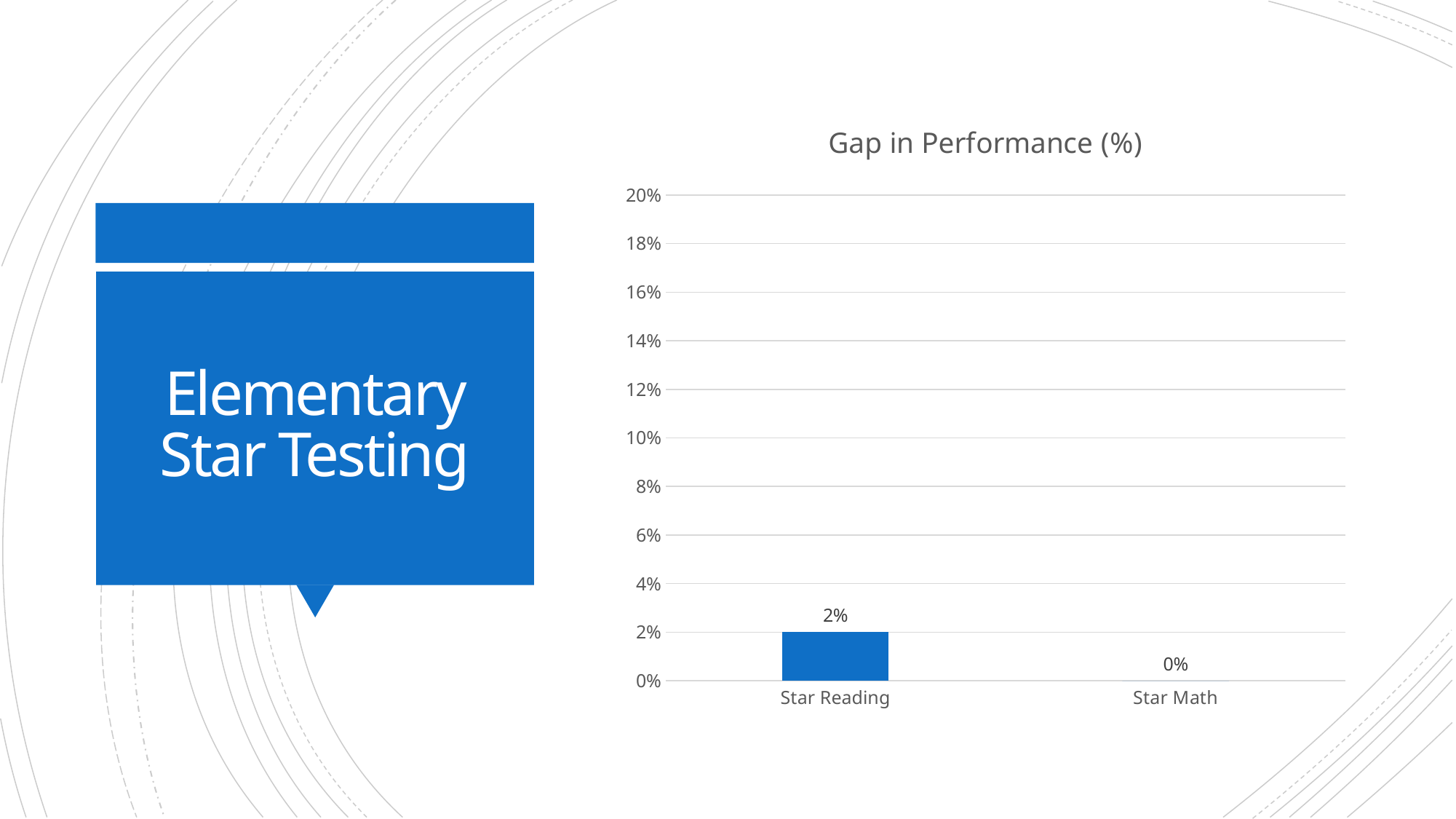
Which category has the highest value? Star Reading What is the title of the chart? Gap in Performance (%) What is the difference between the values for Star Reading and Star Math? 2% What is the value for Star Math? 0% What kind of chart is shown on the slide? bar chart What is the highest value shown on the y axis? 20% Do the values rise or fall from Star Reading to Star Math? fall Is the value for Star Reading greater or less than 10%? less What is the value for Star Reading? 2% Which category has the lowest value? Star Math How many categories are shown on the x axis? 2 Which is larger, the value for Star Reading or the value for Star Math? Star Reading